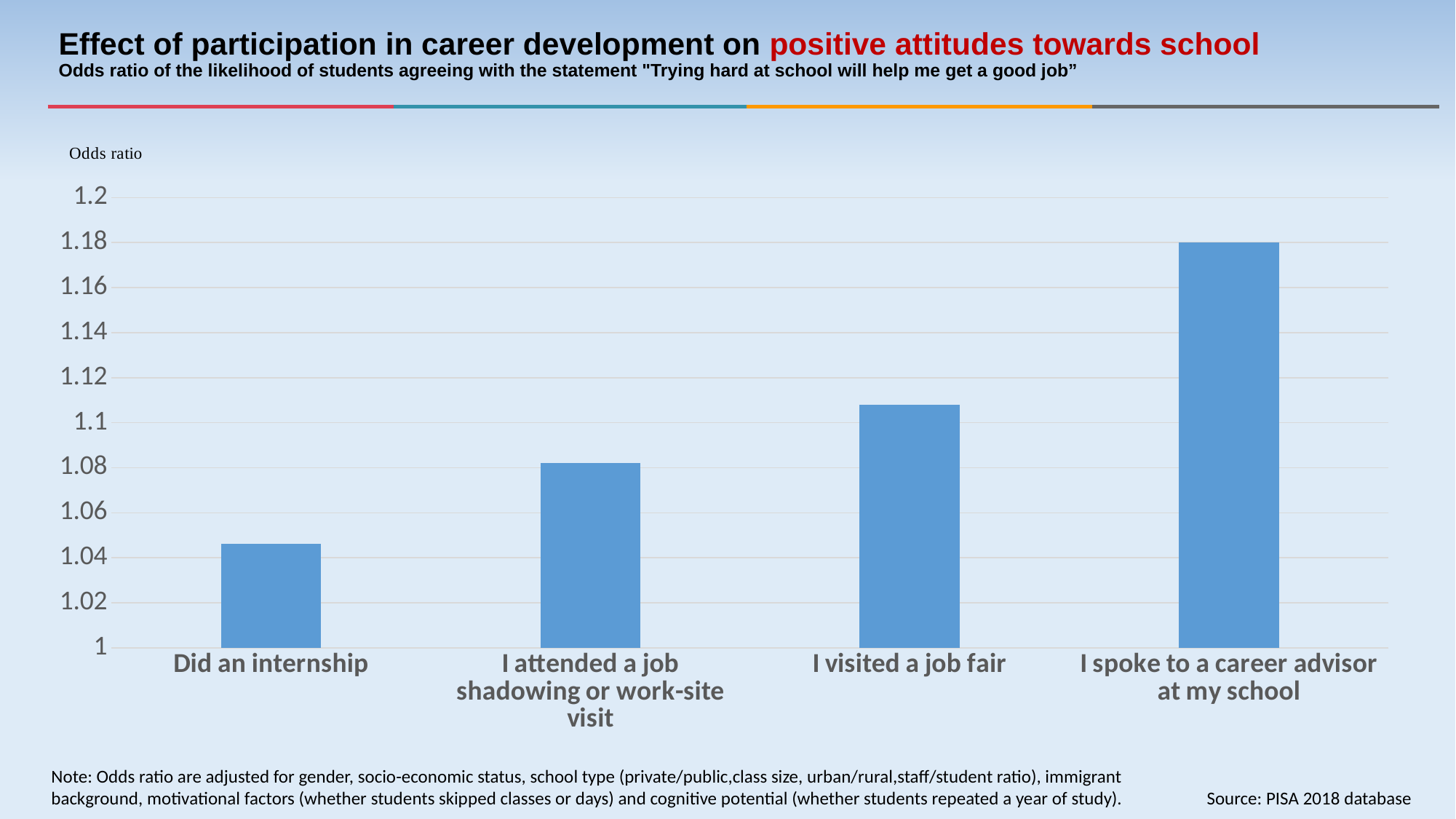
Which has a larger odds ratio: "I visited a job fair" or "I attended a job shadowing or work-site visit"? I visited a job fair Is the odds ratio for "Did an internship" greater or less than 1.06? less Is the odds ratio for "I visited a job fair" greater or less than 1.1? greater Is the odds ratio for "I attended a job shadowing or work-site visit" greater or less than 1.1? less Which career development activity has the highest odds ratio? I spoke to a career advisor at my school How many categories (career development activities) are shown on the x axis? 4 Which has a larger odds ratio: "Did an internship" or "I spoke to a career advisor at my school"? I spoke to a career advisor at my school What is the label of the vertical axis of the chart? Odds ratio What kind of chart is shown on the slide? bar chart Do the odds ratios rise or fall moving from left to right across the categories? rise Which career development activity has the lowest odds ratio? Did an internship